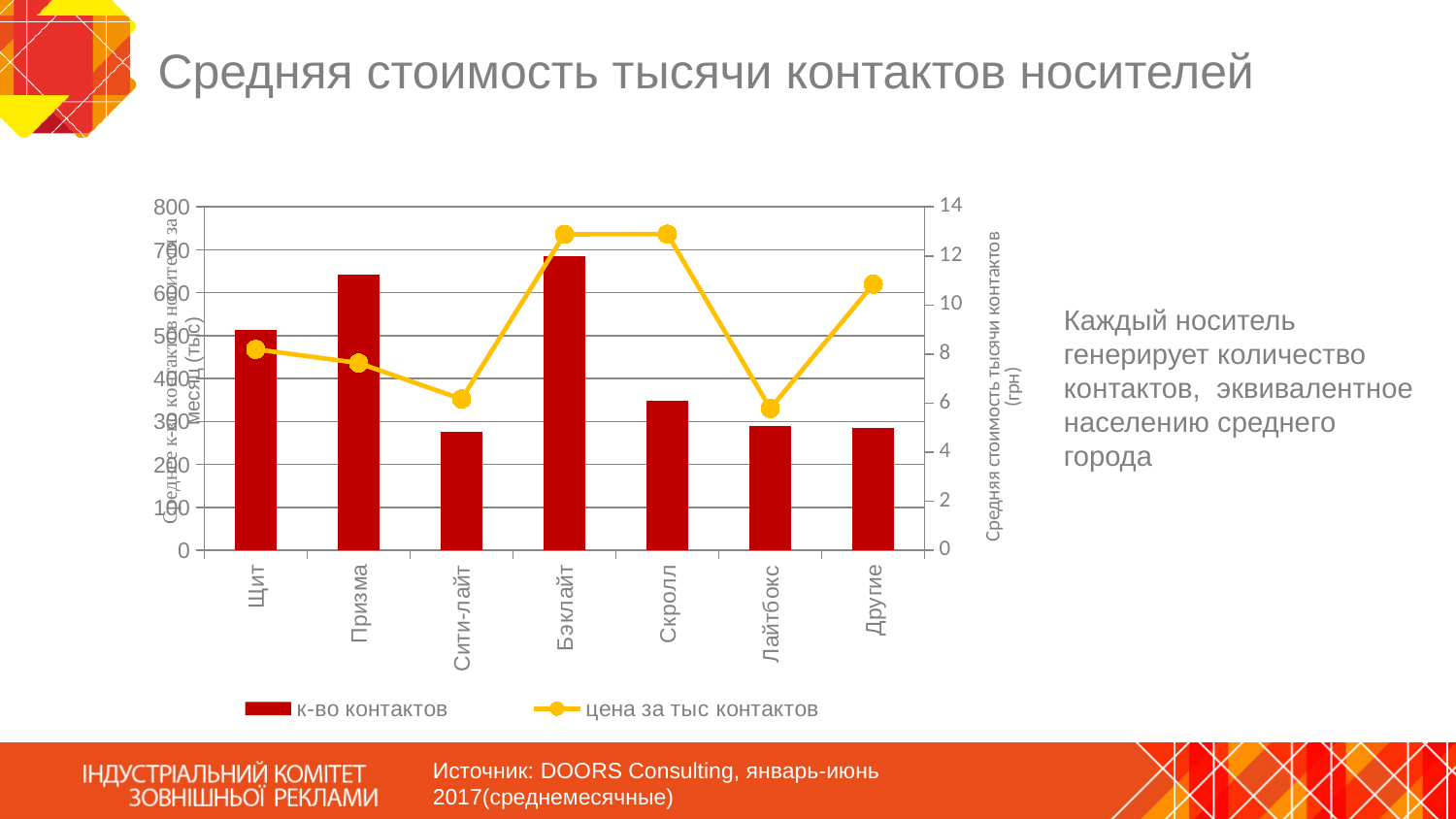
Is the 'к-во контактов' value for Скролл greater or less than 400? less Is the 'к-во контактов' value for Сити-лайт greater or less than 300? less Is the 'к-во контактов' value for Призма greater or less than 600? greater What is the title of the chart on the slide? Средняя стоимость тысячи контактов носителей What type of chart is shown on the slide? A combined bar and line chart How many categories (media types) are shown on the x axis? 7 Which has a higher 'к-во контактов' value, Призма or Скролл? Призма Which category has the highest value for 'к-во контактов'? Бэклайт Which has a higher 'цена за тыс контактов' value, Бэклайт or Лайтбокс? Бэклайт How many series does the legend list? 2